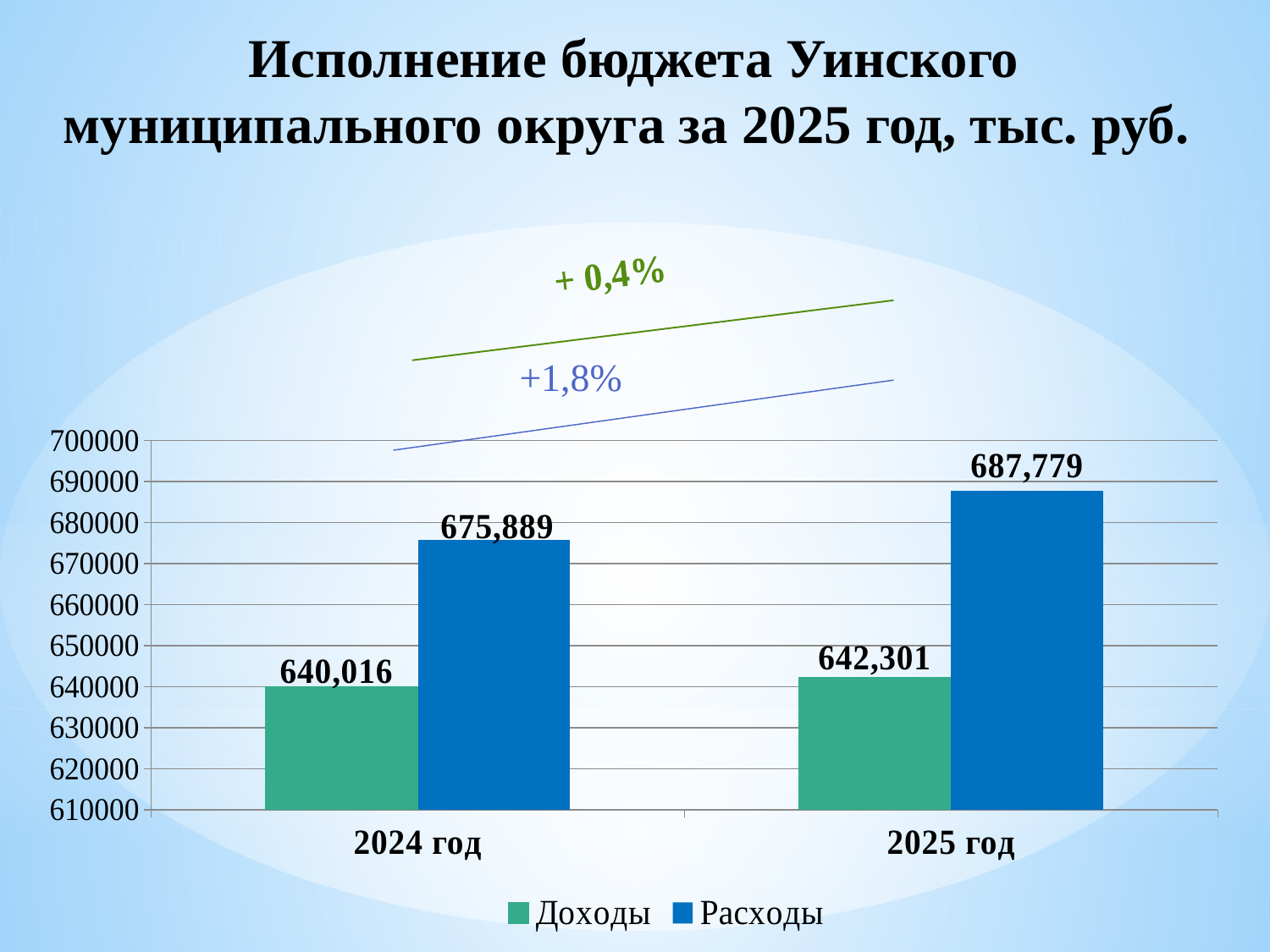
Do the Доходы values rise or fall from 2024 год to 2025 год? Rise Which bar has the highest value on the chart? Расходы, 2025 год How many series does the legend list? 2 Which bar has the lowest value on the chart? Доходы, 2024 год What is the difference between Расходы and Доходы for 2025 год? 45,478 What is the value of Доходы for 2024 год? 640,016 Which is larger for 2024 год, Доходы or Расходы? Расходы What is the value of Расходы for 2025 год? 687,779 By how much did Расходы increase from 2024 год to 2025 год? 11,890 What is the value of Доходы for 2025 год? 642,301 What is the value of Расходы for 2024 год? 675,889 What kind of chart is shown on the slide? Bar chart